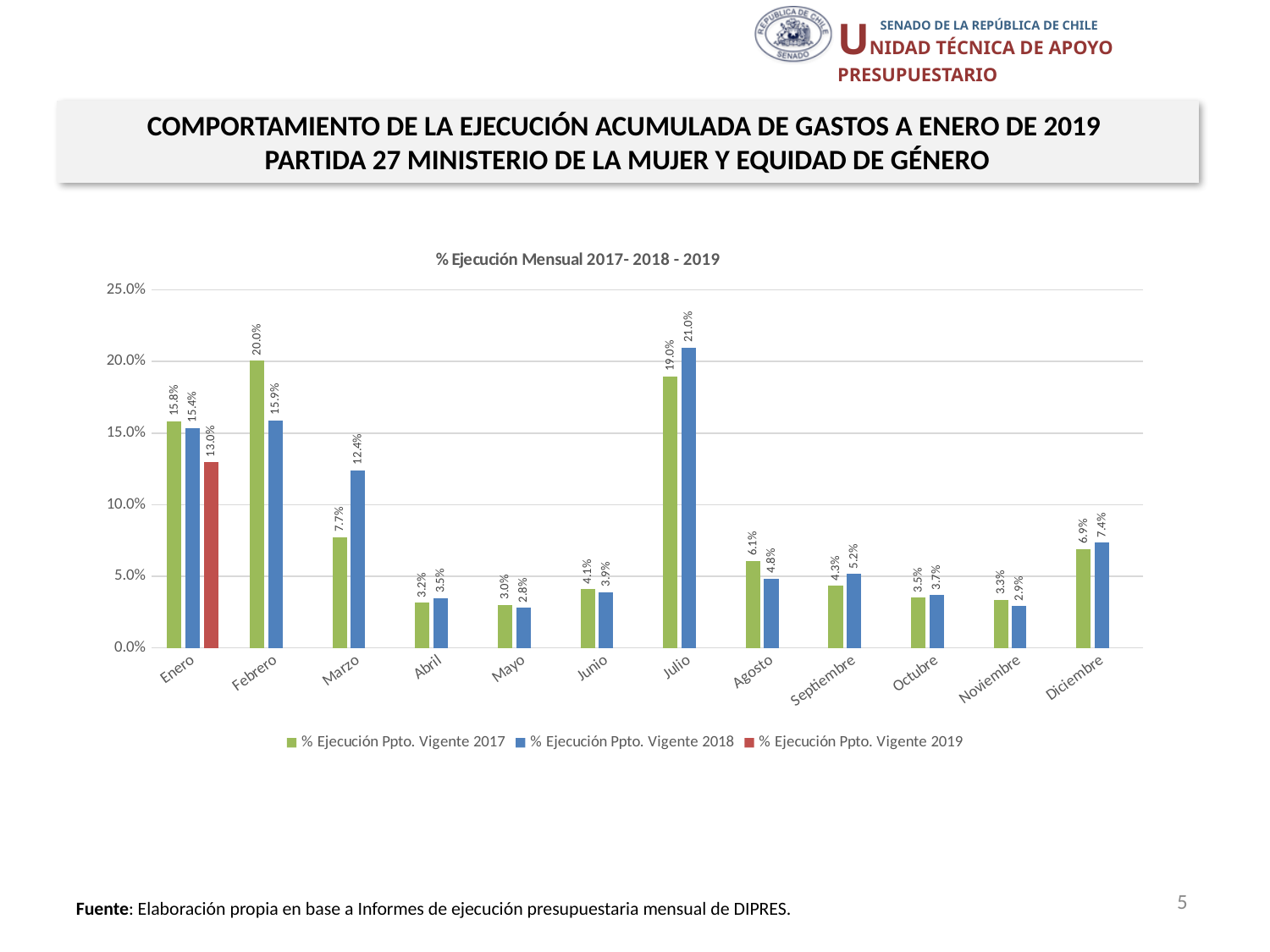
In which month is the % Ejecución Ppto. Vigente 2017 value lowest? Mayo What is the title of the chart? % Ejecución Mensual 2017- 2018 - 2019 Is the value for % Ejecución Ppto. Vigente 2018 in Febrero greater or less than 15.0%? greater Which is larger in Agosto: the 2017 value or the 2018 value? 2017 value (6.1%) In which month is the % Ejecución Ppto. Vigente 2018 value highest? Julio What kind of chart is shown on the slide? Bar chart How many series does the legend list? 3 What is the difference between the 2018 and 2017 values in Julio? 2.0% What is the value for % Ejecución Ppto. Vigente 2018 in Marzo? 12.4% What is the value for % Ejecución Ppto. Vigente 2019 in Enero? 13.0% How many months are shown on the x axis? 12 What is the value for % Ejecución Ppto. Vigente 2017 in Febrero? 20.0%